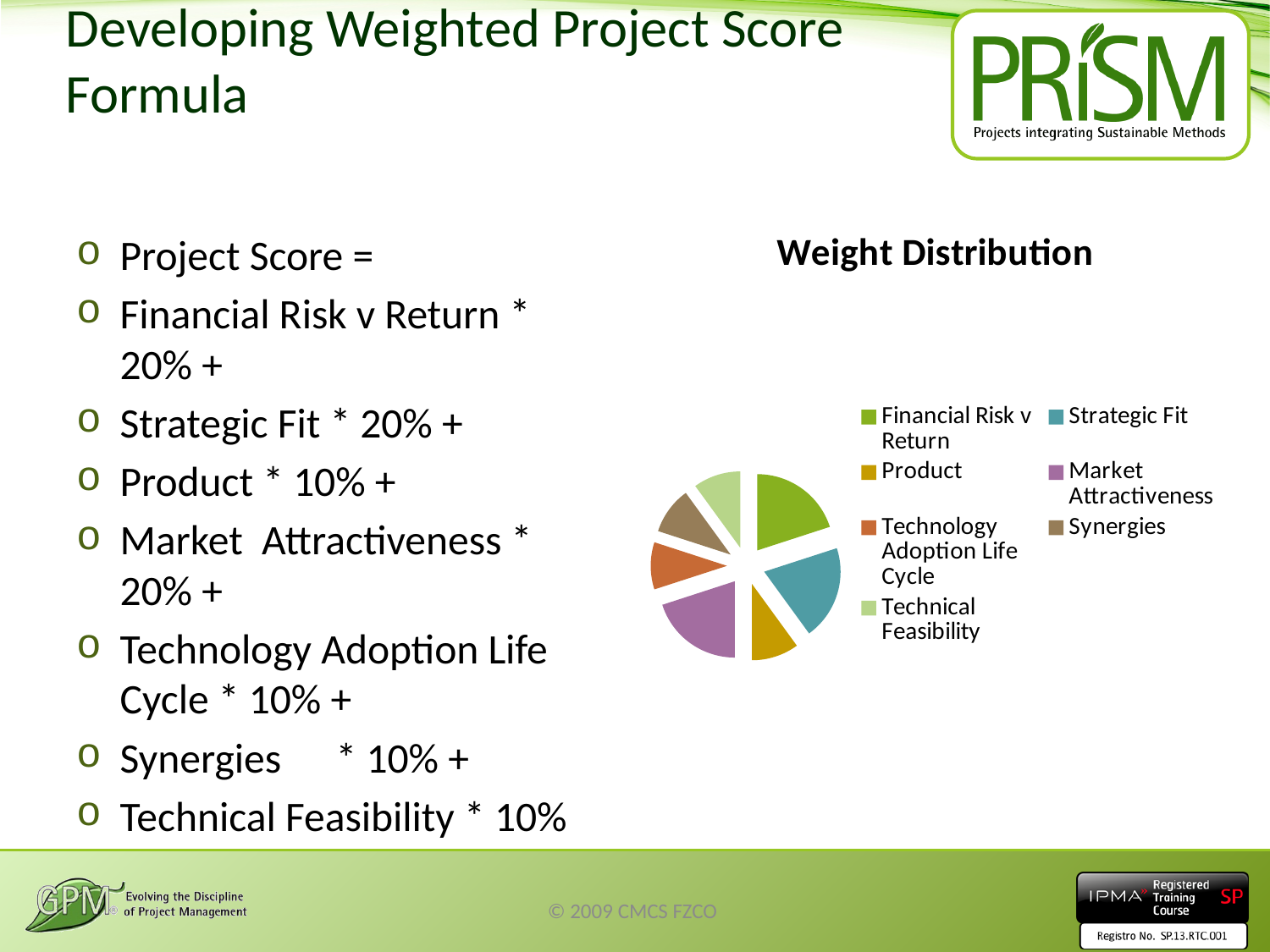
In the Weight Distribution pie chart, which colour represents Financial Risk v Return? Green How many slices does the Weight Distribution pie chart have? 7 In the Weight Distribution pie chart, which slice is larger: Market Attractiveness or Technical Feasibility? Market Attractiveness What kind of chart is shown under the title "Weight Distribution"? Pie chart What is the title of the pie chart on the slide? Weight Distribution In the Weight Distribution pie chart, which slice is larger: Strategic Fit or Synergies? Strategic Fit How many entries does the legend of the Weight Distribution pie chart list? 7 In the Weight Distribution pie chart, which slice is larger: Financial Risk v Return or Product? Financial Risk v Return